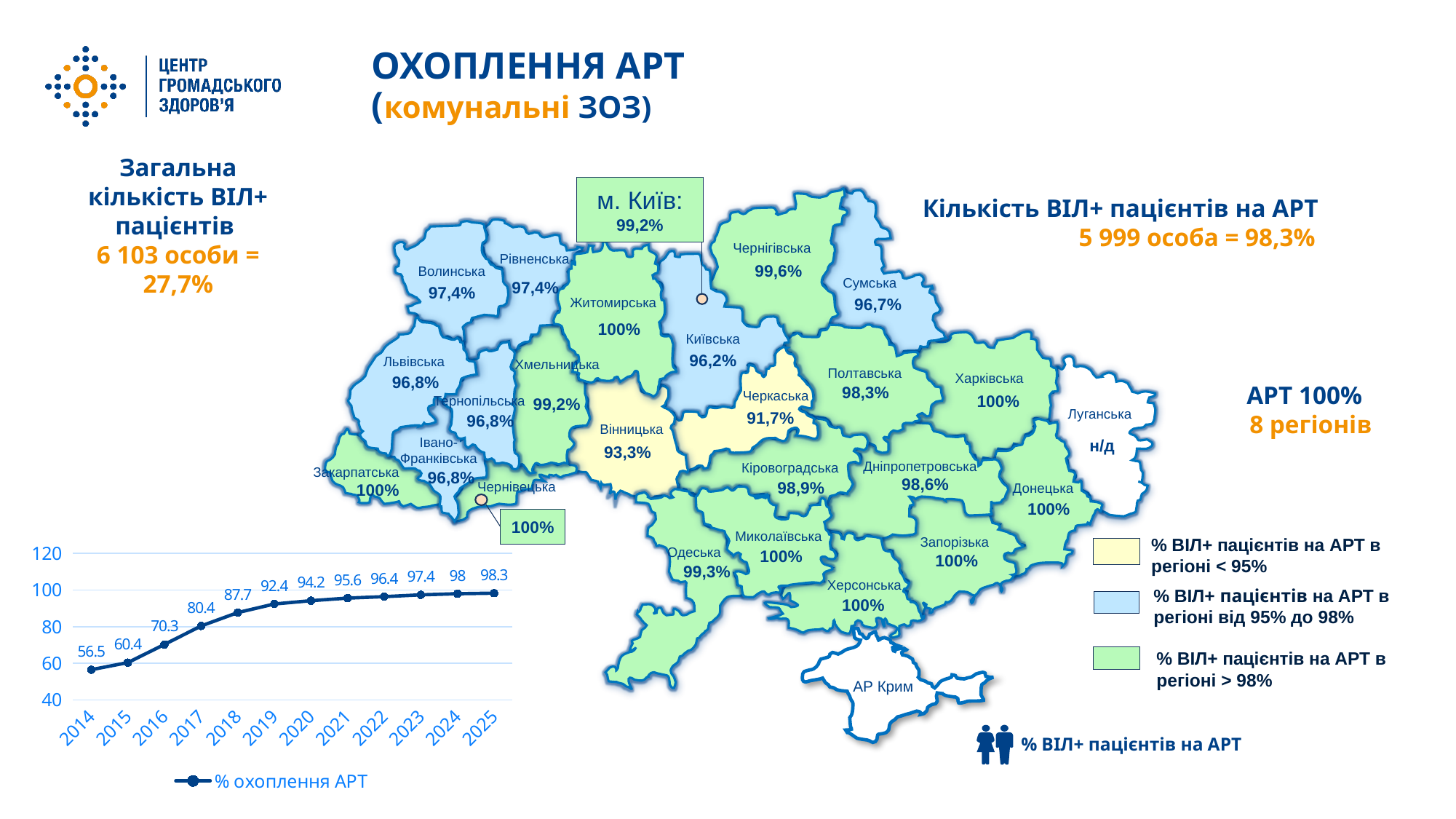
In the line chart, which is larger: the value for 2015 or the value for 2019? 2019 In the line chart, which year has the lowest value? 2014 In the line chart, which year has the highest value? 2025 Do the values in the line chart rise or fall from 2014 to 2025? rise In the line chart, what is the value for 2025? 98.3 In the line chart, what is the difference between the values for 2017 and 2016? 10.1 How many years (data points) are plotted in the line chart? 12 In the line chart, what is the value for 2014? 56.5 In the line chart, what is the value for 2018? 87.7 What type of chart is shown in the bottom-left of the slide? line chart What series name is shown in the legend of the line chart? % охоплення АРТ In the line chart, what is the value for 2024? 98